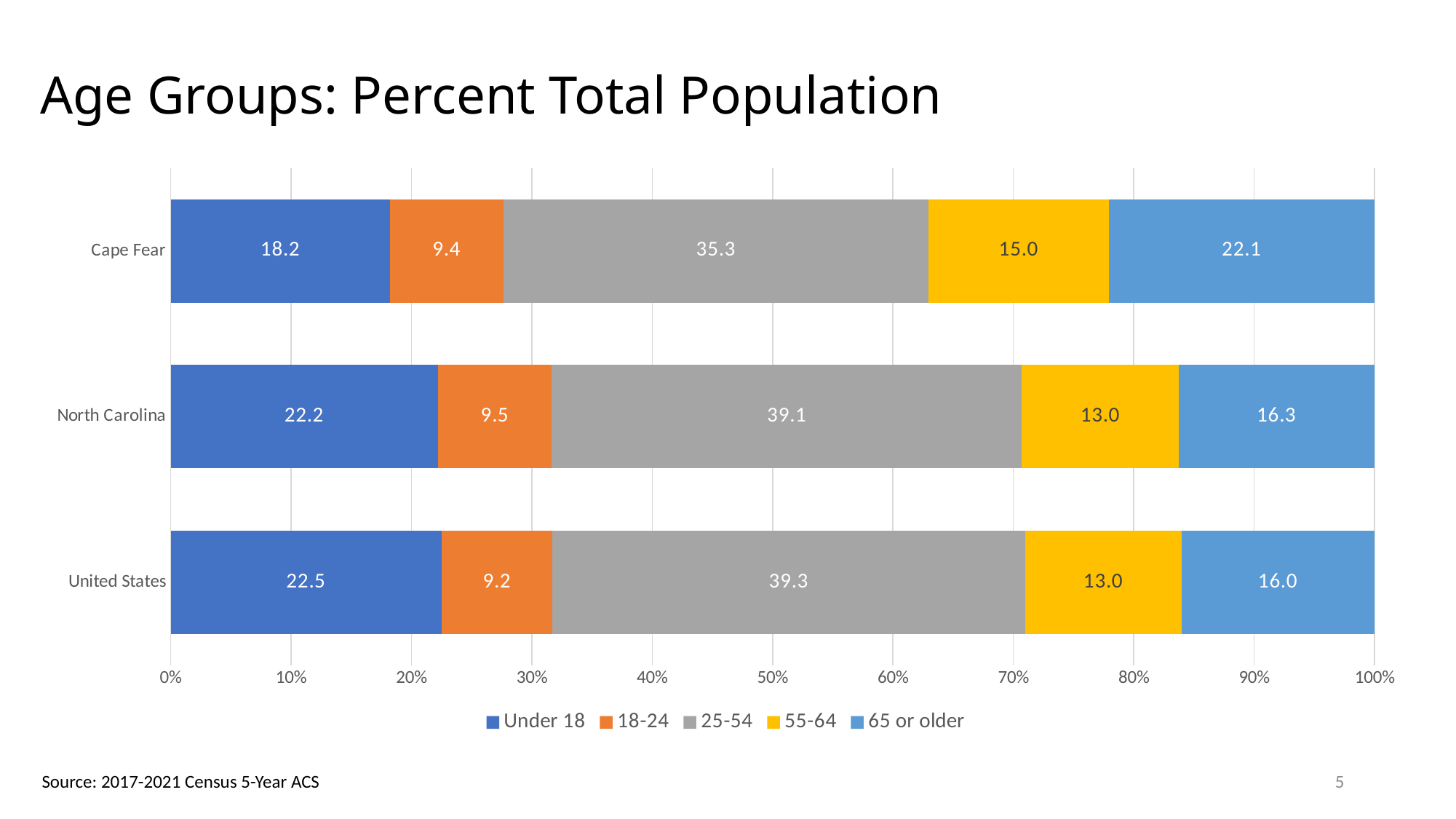
Which region has the lowest value for the Under 18 age group? Cape Fear What is the value for the Under 18 age group in the United States? 22.5 Which region has the highest value for the 65 or older age group? Cape Fear What kind of chart is shown on the slide? Stacked bar chart Which is larger: the 55-64 value for Cape Fear or for North Carolina? Cape Fear What is the difference between the 25-54 values for the United States and Cape Fear? 4.0 What colour represents the 18-24 age group in the chart? Orange How many age groups does the legend list? 5 What is the value for the 65 or older age group in North Carolina? 16.3 What is the value for the 25-54 age group in Cape Fear? 35.3 What is the total of the Cape Fear bar? 100.0 How many regions are shown on the chart? 3